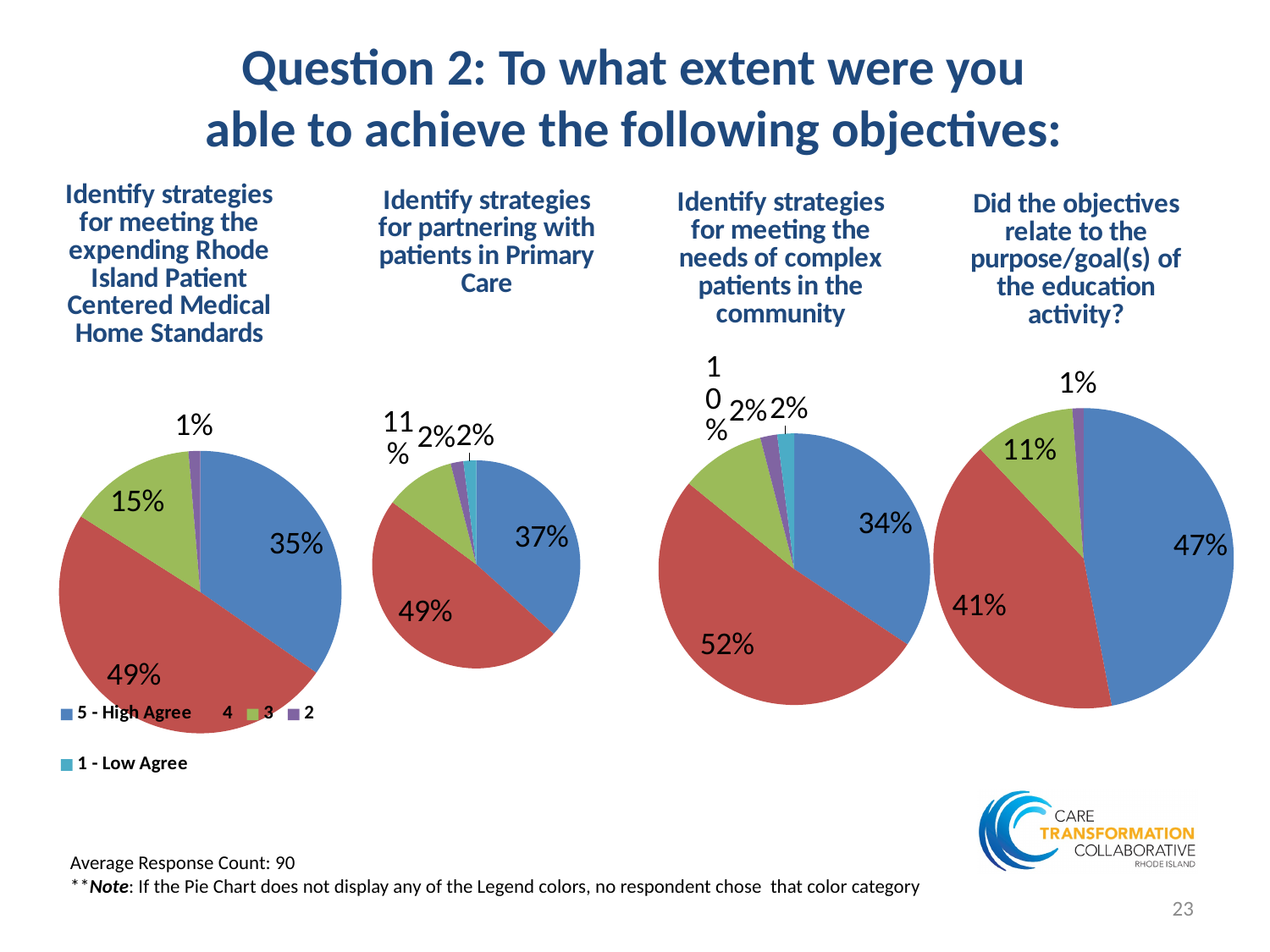
How many categories does the legend list? 5 How many pie charts are shown on the slide? 4 In the pie chart titled 'Identify strategies for meeting the needs of complex patients in the community', what is the difference between the share for '4' and the share for '5 - High Agree'? 18% In the pie chart titled 'Did the objectives relate to the purpose/goal(s) of the education activity?', what is the difference between the share for '5 - High Agree' and the share for '3'? 36% What type of chart is used on this slide? Pie chart In the leftmost pie chart (Rhode Island Patient Centered Medical Home Standards), which response category has the smallest share? 2 In the pie chart titled 'Did the objectives relate to the purpose/goal(s) of the education activity?', which response category has the largest share? 5 - High Agree In the pie chart titled 'Identify strategies for meeting the needs of complex patients in the community', what share of respondents chose '3'? 10% In the leftmost pie chart (Rhode Island Patient Centered Medical Home Standards), which response category has the largest share? 4 In the pie chart titled 'Identify strategies for partnering with patients in Primary Care', which is larger: the share for '4' or the share for '5 - High Agree'? 4 In the pie chart titled 'Identify strategies for partnering with patients in Primary Care', what share of respondents chose '5 - High Agree'? 37% In the pie chart titled 'Did the objectives relate to the purpose/goal(s) of the education activity?', what share of respondents chose '4'? 41%